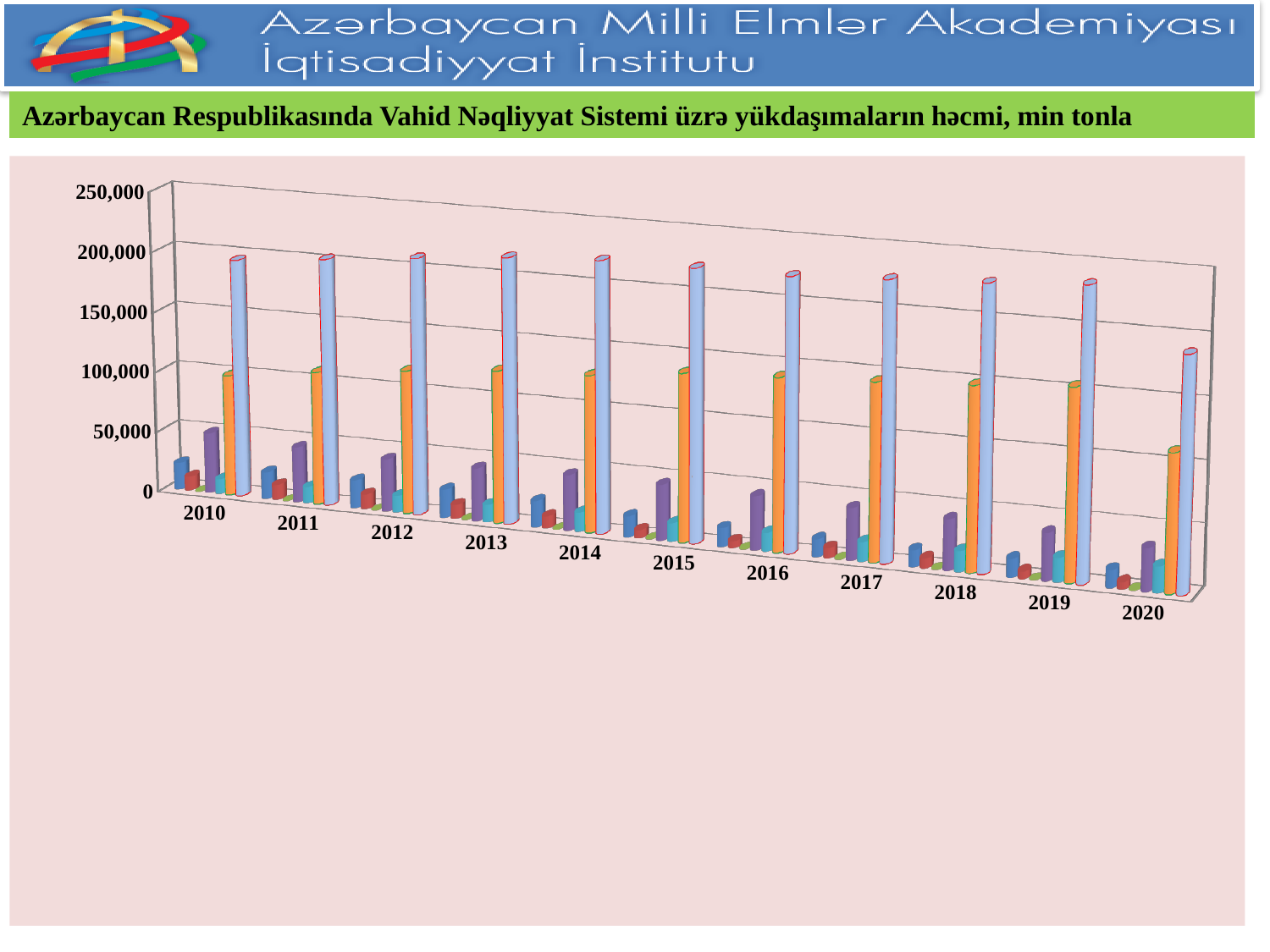
Is the value of the dark blue bar for 2010 greater or less than 50,000? less What kind of chart is shown on the slide? bar chart In which year is the light blue bar the lowest? 2020 Is the value of the tallest (light blue) bar for 2010 greater or less than 150,000? greater What is the highest value shown on the vertical axis? 250,000 What is the first year shown on the x axis? 2010 How many years are shown on the x axis of the chart? 11 Is the value of the light blue bar for 2020 greater or less than 50,000? greater For 2010, which is larger: the light blue bar or the orange bar? the light blue bar For 2010, which is larger: the purple bar or the red bar? the purple bar